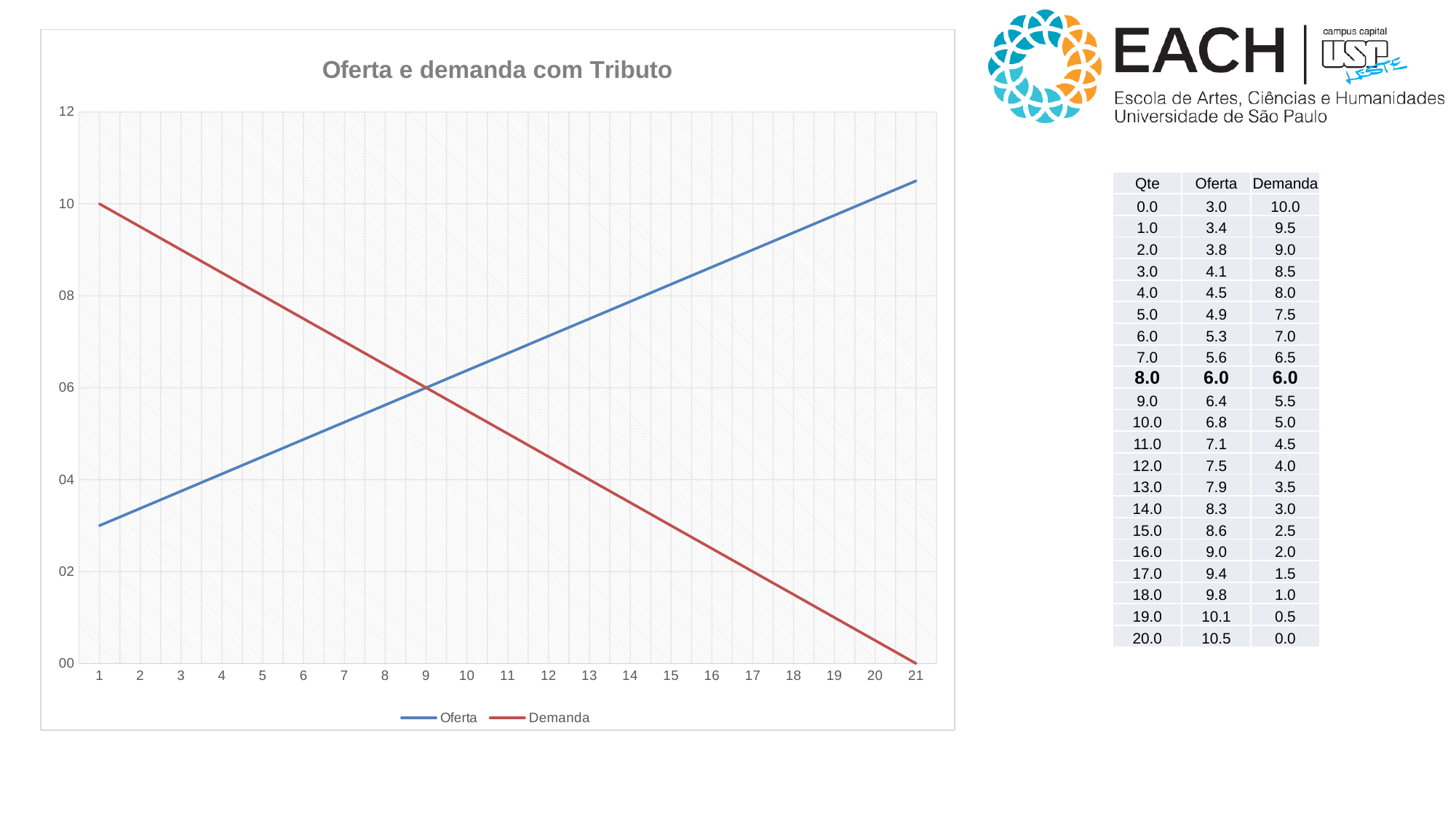
Is the value of Oferta at x = 1 greater or less than 4? less Does the Demanda line rise or fall as the x axis increases? falls At x = 3, which series has the higher value, Oferta or Demanda? Demanda What is the value of Demanda at x = 1? 10 What are the two series named in the legend? Oferta and Demanda How many points are labelled along the x axis? 21 What is the title of the chart? Oferta e demanda com Tributo Does the Oferta line rise or fall as the x axis increases? rises What kind of chart is shown on the slide? line chart How many series does the chart's legend list? 2 At x = 15, which series has the higher value, Oferta or Demanda? Oferta Is the value of Oferta at x = 21 greater or less than 8? greater